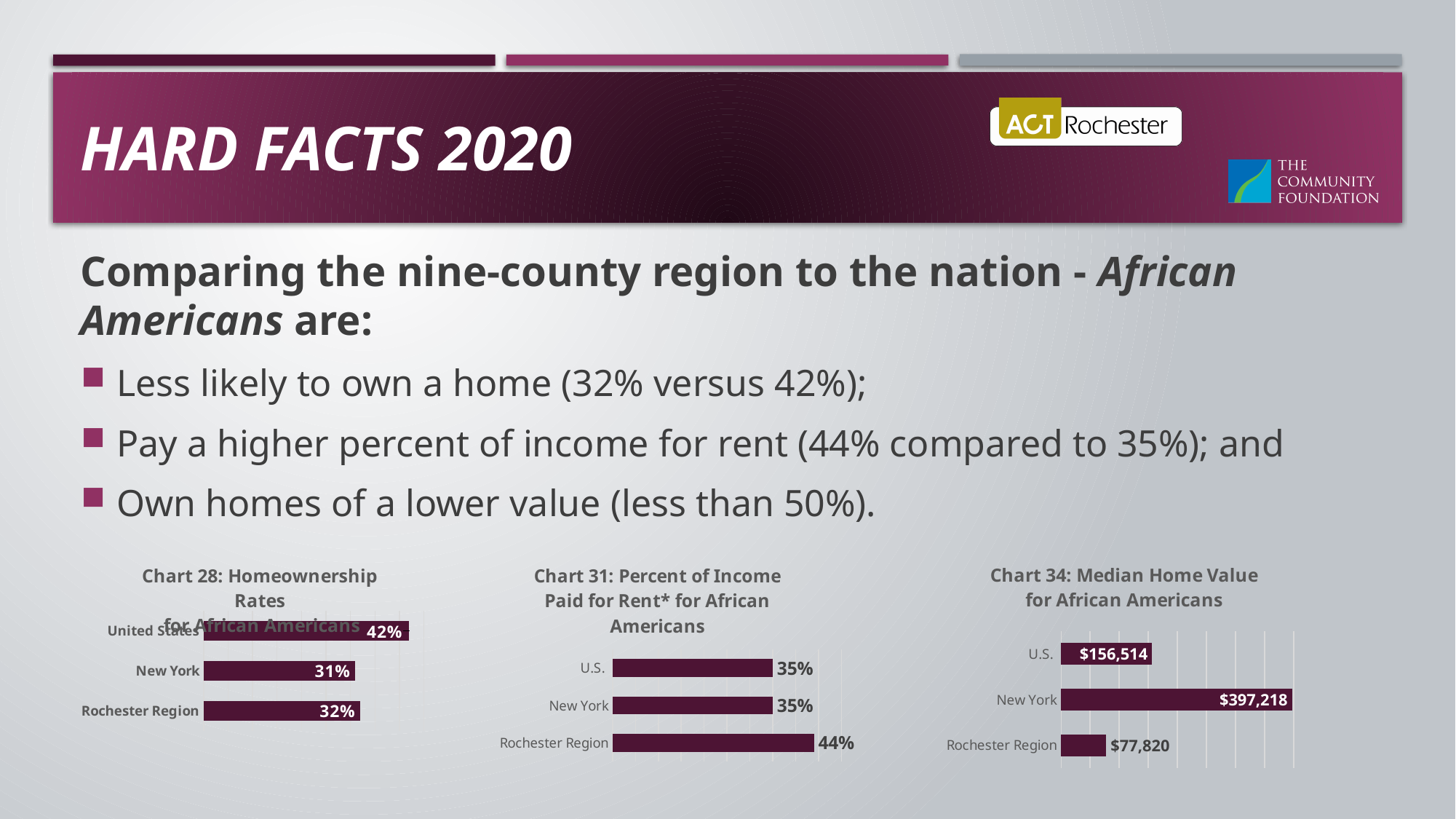
In Chart 28: Homeownership Rates for African Americans, which category has the highest value? United States How many categories are shown in Chart 31: Percent of Income Paid for Rent for African Americans? 3 In Chart 34: Median Home Value for African Americans, which category has the lowest value? Rochester Region In Chart 31: Percent of Income Paid for Rent for African Americans, which category has the highest value? Rochester Region In Chart 31: Percent of Income Paid for Rent for African Americans, what is the value for Rochester Region? 44% In Chart 34: Median Home Value for African Americans, what is the difference between the U.S. and Rochester Region values? $78,694 In Chart 34: Median Home Value for African Americans, is the value for U.S. or Rochester Region larger? U.S. In Chart 28: Homeownership Rates for African Americans, what is the value for New York? 31% What type of chart is Chart 34: Median Home Value for African Americans? Bar chart In Chart 28: Homeownership Rates for African Americans, what is the difference between the United States and Rochester Region values? 10% In Chart 34: Median Home Value for African Americans, what is the value for New York? $397,218 In Chart 31: Percent of Income Paid for Rent for African Americans, what is the difference between Rochester Region and U.S.? 9%